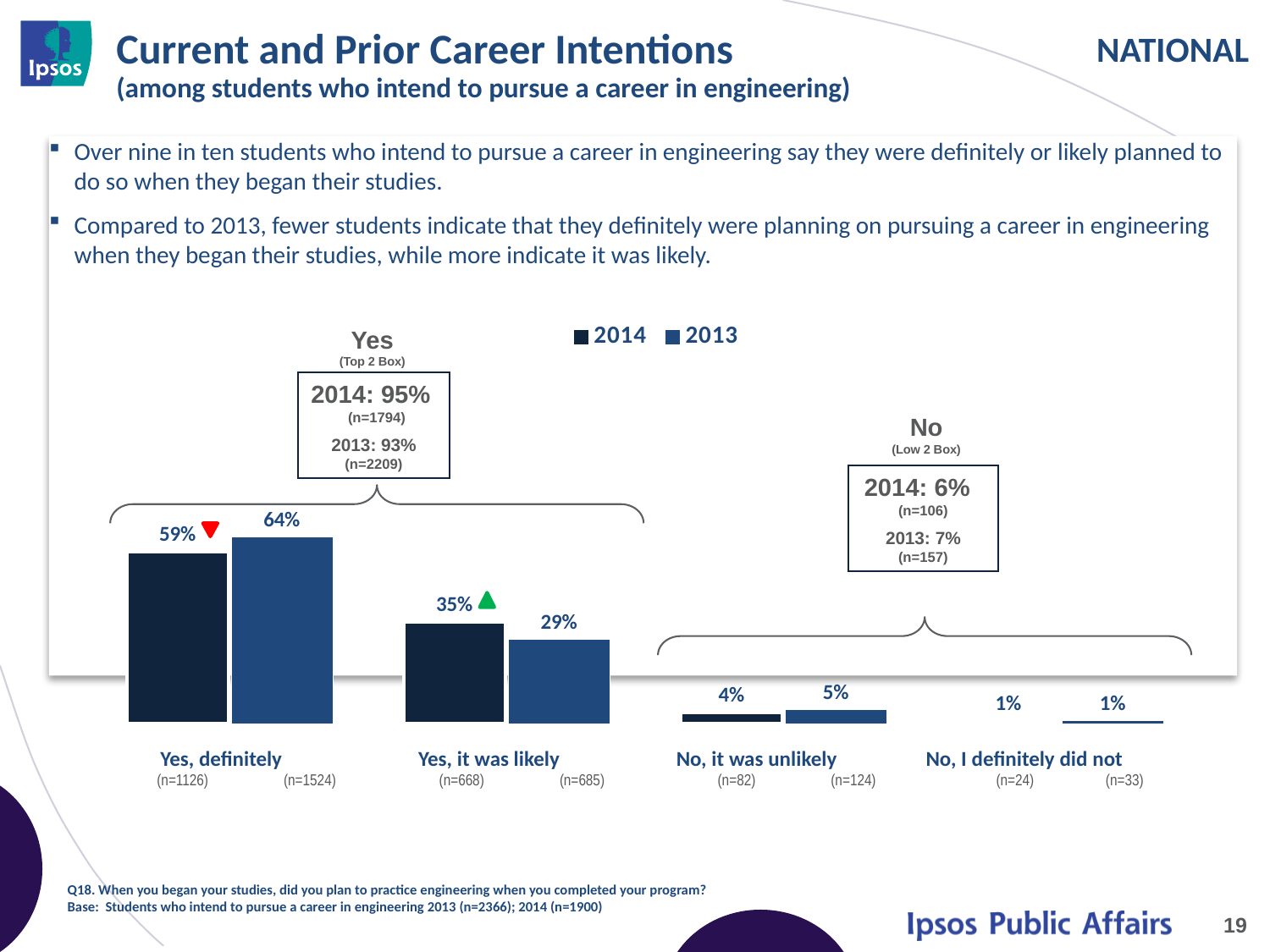
What is the 2014 "Yes (Top 2 Box)" percentage shown in the box above the chart? 95% What is the 2014 value for "Yes, definitely"? 59% What is the 2013 value for "Yes, it was likely"? 29% Which category has the highest 2013 value? Yes, definitely For "Yes, it was likely", which year has the larger value, 2014 or 2013? 2014 What kind of chart is shown on the slide? Bar chart What is the 2013 value for "No, it was unlikely"? 5% How many series does the chart legend list? 2 Which category has the lowest 2014 value? No, I definitely did not What is the difference between the 2013 and 2014 values for "Yes, definitely"? 5% What is the difference between the 2014 and 2013 values for "Yes, it was likely"? 6% How many categories are shown on the x axis of the chart? 4